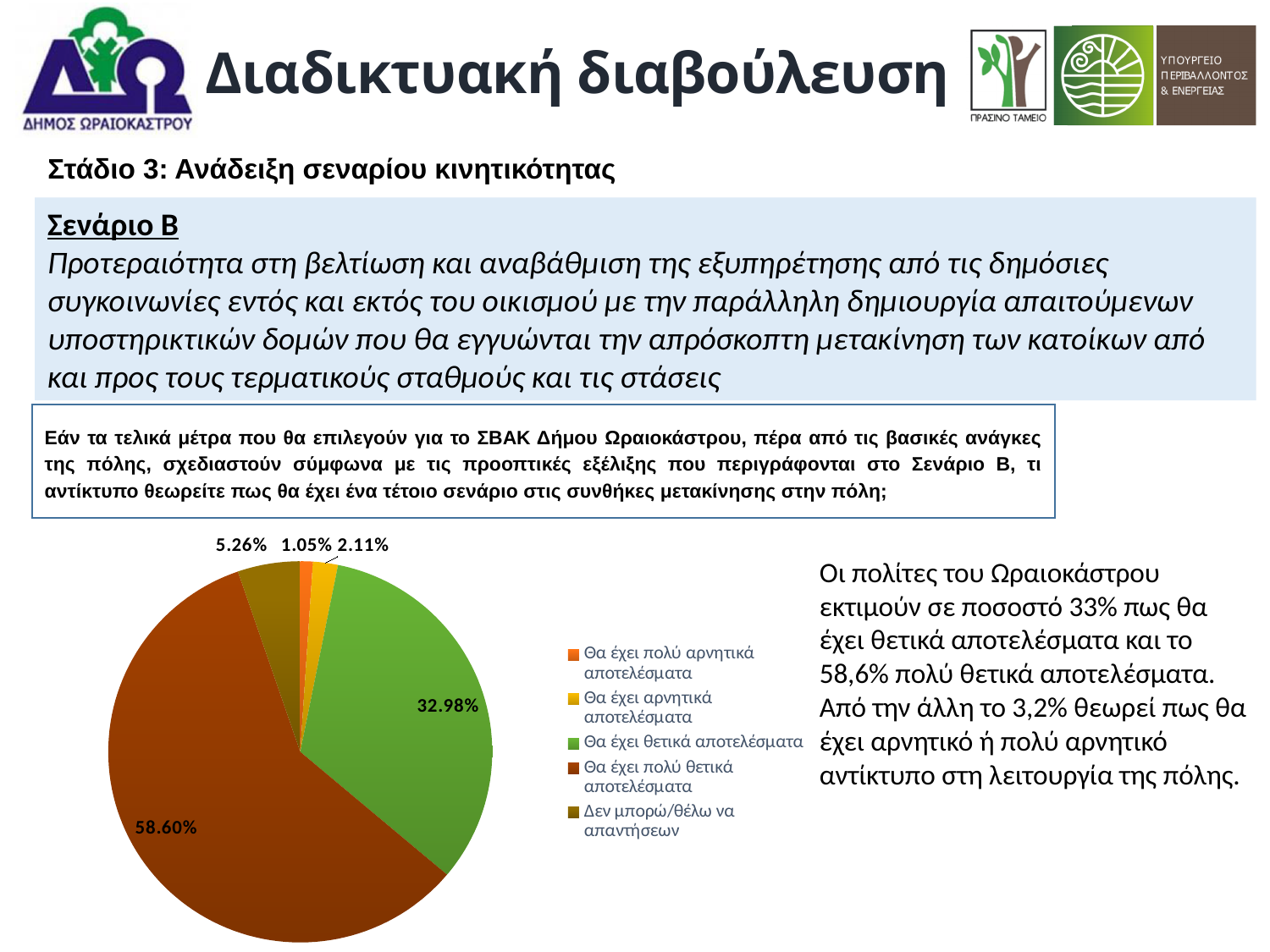
What is the difference in percentage points between the "Θα έχει πολύ θετικά αποτελέσματα" slice and the "Θα έχει θετικά αποτελέσματα" slice? 25.62% What percentage of the pie corresponds to "Δεν μπορώ/θέλω να απαντήσεων"? 5.26% How many entries does the legend of the pie chart list? 5 What type of chart is shown on the slide? pie chart What percentage of the pie corresponds to "Θα έχει πολύ αρνητικά αποτελέσματα"? 1.05% Which slice is larger: "Θα έχει αρνητικά αποτελέσματα" or "Δεν μπορώ/θέλω να απαντήσεων"? Δεν μπορώ/θέλω να απαντήσεων What percentage of the pie corresponds to "Θα έχει αρνητικά αποτελέσματα"? 2.11% Which category has the largest slice of the pie chart? Θα έχει πολύ θετικά αποτελέσματα How many slices does the pie chart have? 5 Which category has the smallest slice of the pie chart? Θα έχει πολύ αρνητικά αποτελέσματα